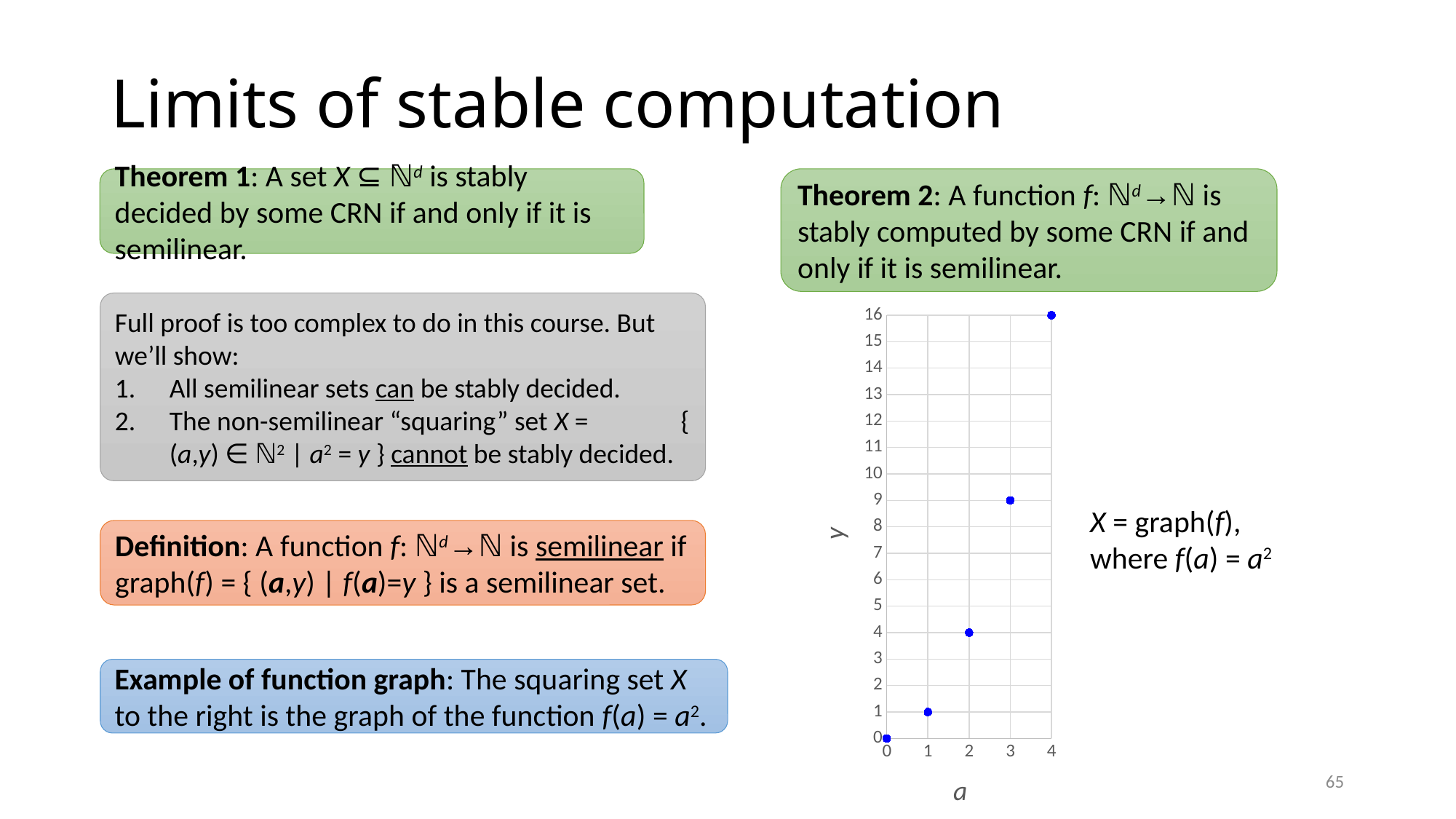
How many points are plotted on the chart? 5 Which has the larger y value: the point at a = 2 or the point at a = 3? a = 3 What kind of chart is shown on the slide? scatter plot What is the y value of the point at a = 4? 16 What is the y value of the point at a = 1? 1 What is the label of the horizontal axis of the chart? a Do the y values rise or fall as a increases along the x axis? rise What is the y value of the point at a = 2? 4 At which value of a is the plotted y value highest? 4 What is the y value of the point at a = 3? 9 What is the difference between the y values at a = 4 and a = 3? 7 At which value of a is the plotted y value lowest? 0